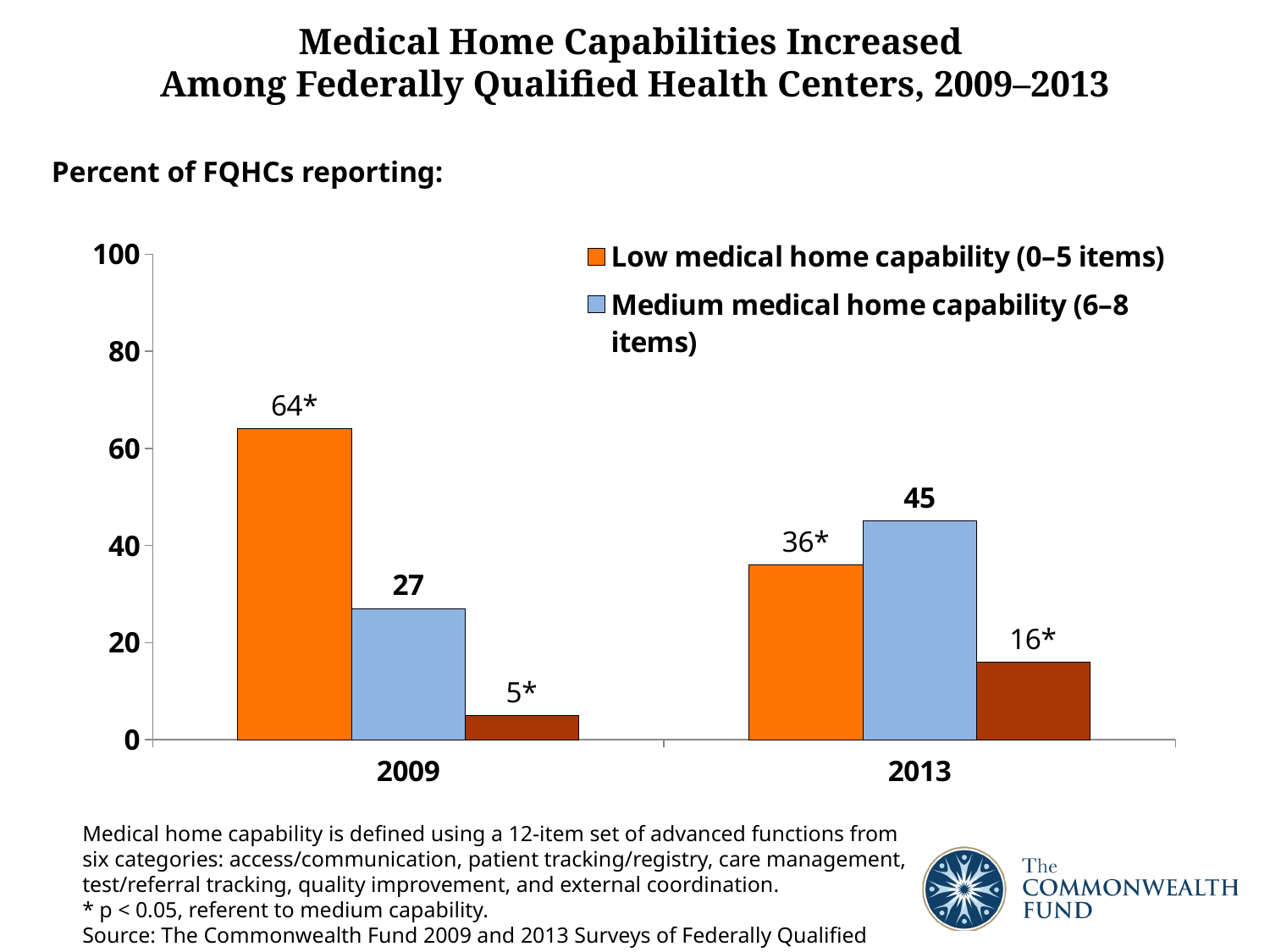
What is the value for Medium medical home capability (6–8 items) in 2013? 45 What is the value for Low medical home capability (0–5 items) in 2009? 64* How many years are shown on the x axis? 2 How many series does the legend list? 2 In 2013, which is larger: Low medical home capability or Medium medical home capability? Medium medical home capability Does the Medium medical home capability value rise or fall from 2009 to 2013? rise What kind of chart is shown on the slide? bar chart By how much did the Low medical home capability value fall from 2009 to 2013? 28 By how much did the Medium medical home capability value rise from 2009 to 2013? 18 What is the value for Medium medical home capability (6–8 items) in 2009? 27 What is the value for Low medical home capability (0–5 items) in 2013? 36* Does the Low medical home capability value rise or fall from 2009 to 2013? fall